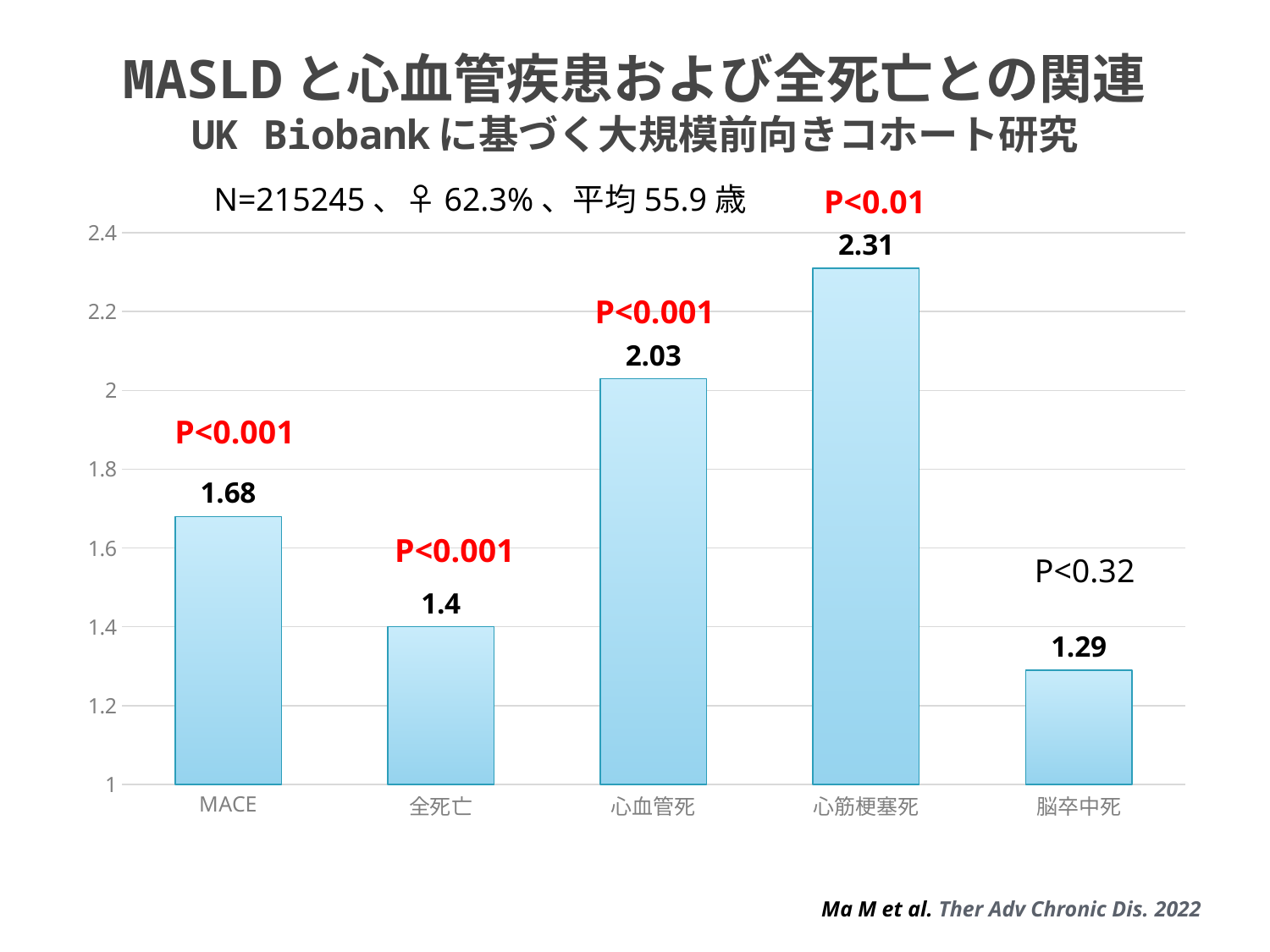
Which category has the highest value? 心筋梗塞死 What is the value for 全死亡? 1.4 What is the difference between the values for 心筋梗塞死 and 心血管死? 0.28 Is the value for 心血管死 greater or less than 2? greater What is the value for 脳卒中死? 1.29 How many categories are shown on the x axis? 5 Which is larger, the value for MACE or the value for 全死亡? MACE Which category has the lowest value? 脳卒中死 What P value is shown above the 脳卒中死 bar? P<0.32 What is the value for MACE? 1.68 What is the value for 心血管死? 2.03 What kind of chart is shown on the slide? bar chart